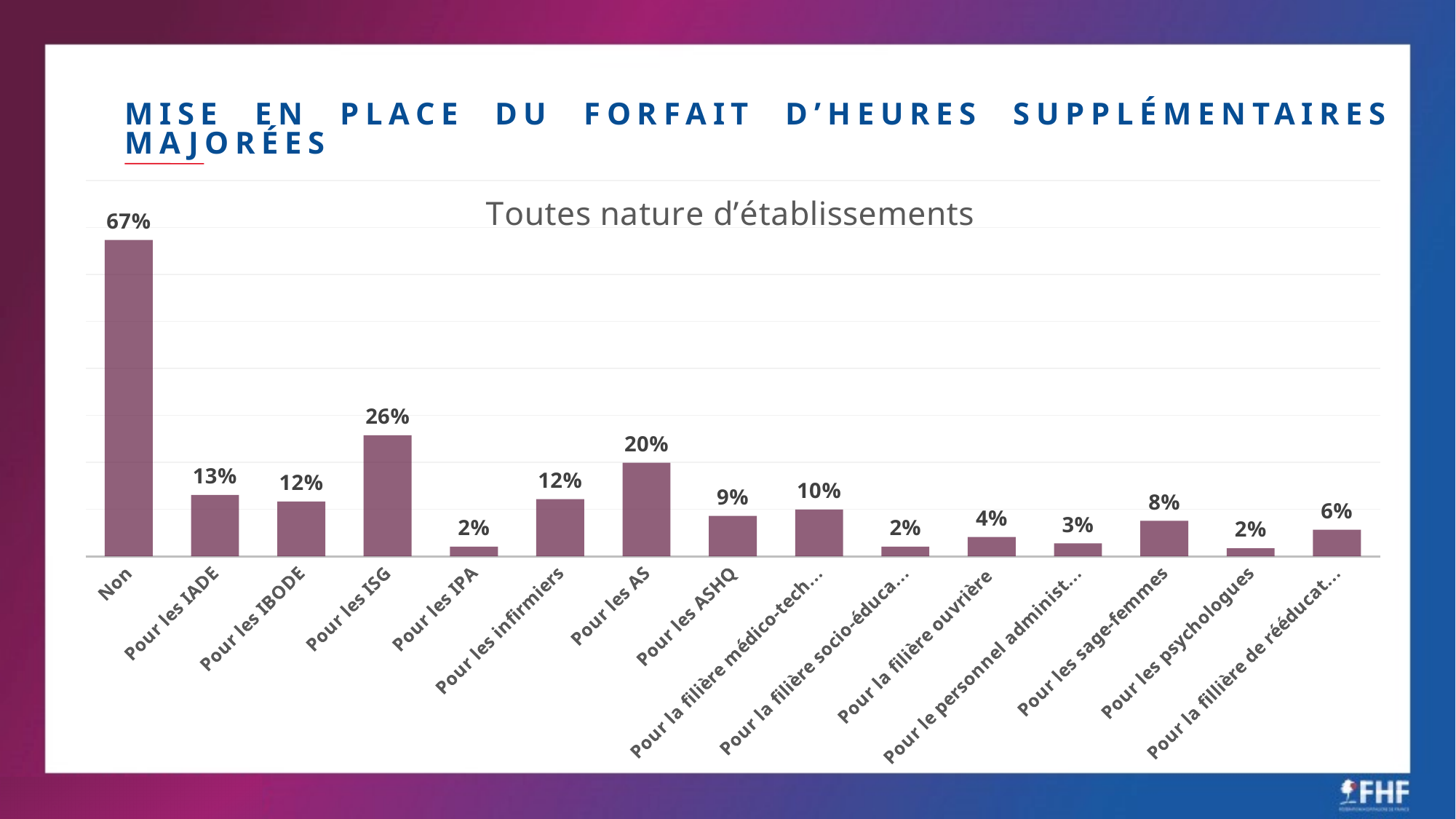
What value is shown for "Pour les AS"? 20% What value is shown for "Pour les ISG"? 26% What value is shown for "Pour les sage-femmes"? 8% What value is shown for "Non"? 67% Which category has the highest value? Non How many categories are shown on the x axis? 15 Which is larger, the value for "Pour les ASHQ" or the value for "Pour les IBODE"? Pour les IBODE What is the difference between the values for "Pour les ISG" and "Pour les AS"? 6% What value is shown for "Pour la filière ouvrière"? 4% What is the title of the chart? Toutes nature d'établissements What kind of chart is shown on the slide? Bar chart What is the difference between the values for "Non" and "Pour les IADE"? 54%